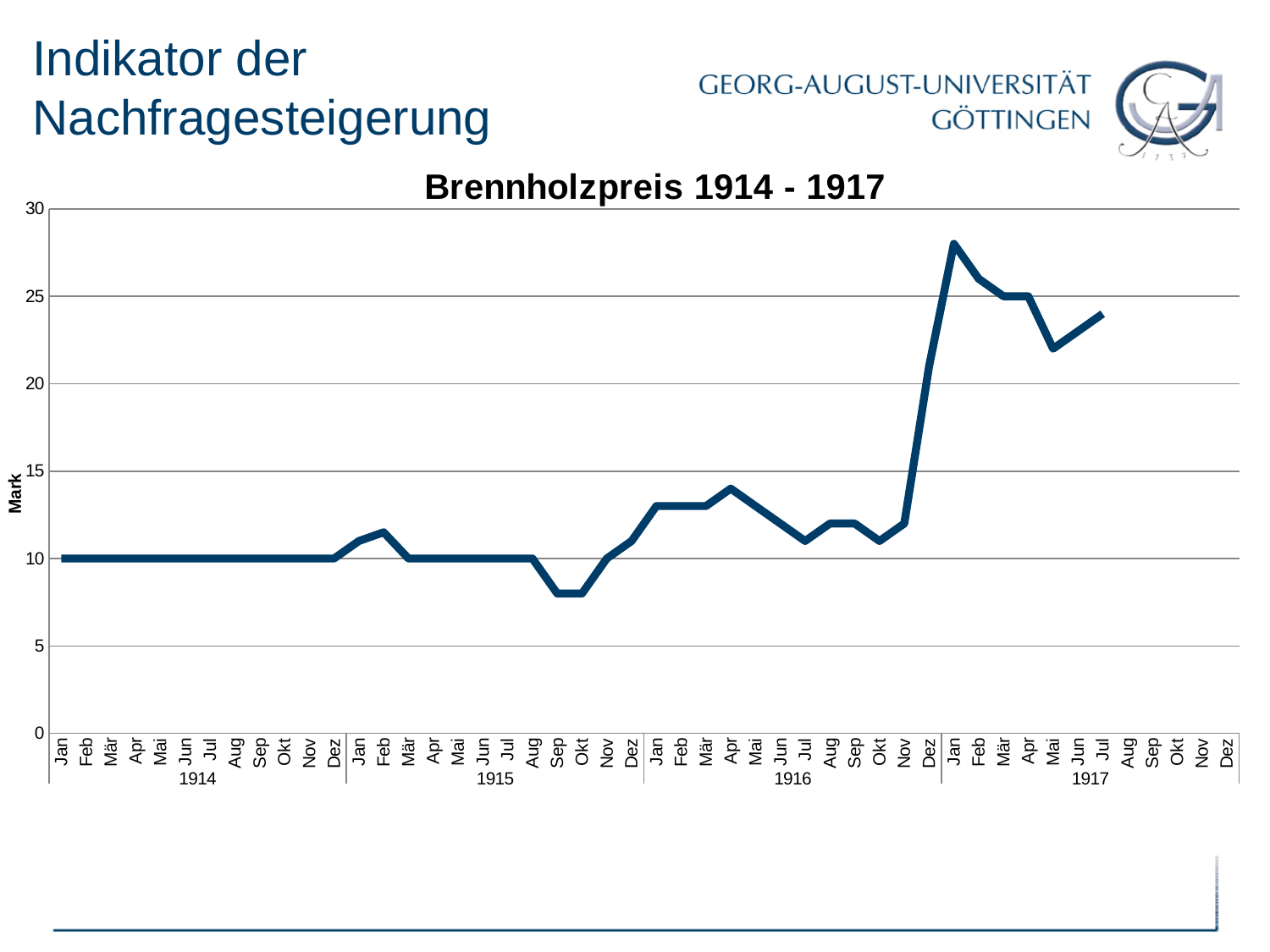
Which is larger, the value for Jan 1914 or the value for Jan 1917? Jan 1917 In which month and year does the line reach its highest value? Jan 1917 In which year does the lowest value of the line occur? 1915 Is the value for Sep 1915 greater or less than 10? less What is the title of the chart? Brennholzpreis 1914 - 1917 Is the value for Jan 1917 greater or less than 25? greater What is the value for Jan 1914? 10 What is the label on the vertical axis of the chart? Mark Is the value for Apr 1916 greater or less than 15? less Overall, does the line rise or fall from Jan 1914 to Jul 1917? rise What type of chart is shown on the slide? line chart What is the value for Apr 1917? 25